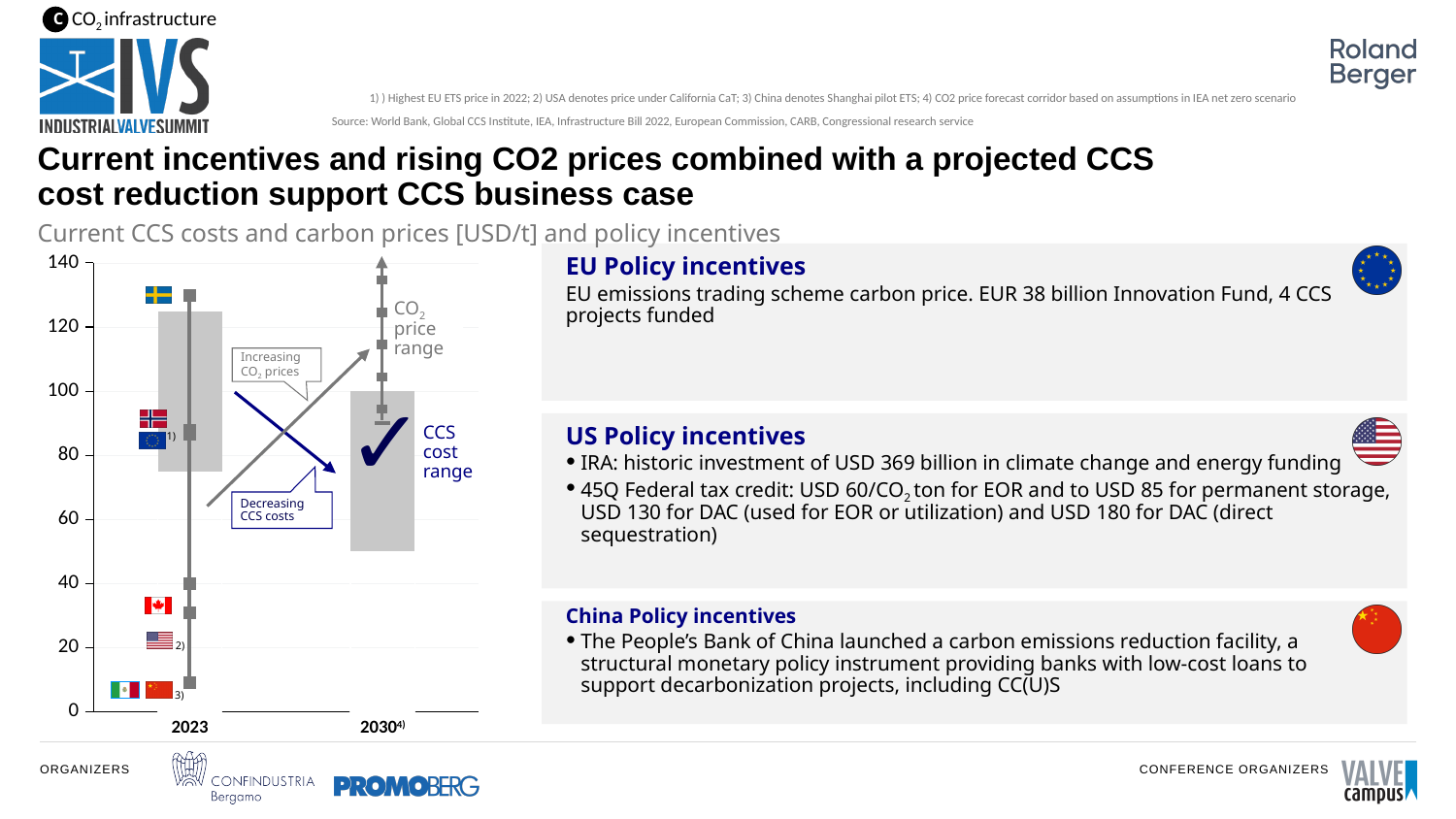
Is the 2023 value for Canada greater or less than 40? less What kind of chart is shown on the left of the slide? combination bar and line chart (gray range bars with point markers) Is the 2023 value for Norway greater or less than 80? greater Is the 2023 value for Sweden greater or less than 120? greater What is the highest value shown on the y axis of the chart? 140 Which country has the highest 2023 carbon price in the chart? Sweden What are the two categories on the x axis of the chart? 2023 and 2030 According to the chart, do CCS costs rise or fall from 2023 to 2030? fall How many categories are shown on the x axis of the chart? 2 According to the chart, do CO2 prices rise or fall from 2023 to 2030? rise Which is higher in 2023, the value for Sweden or the value for Canada? Sweden